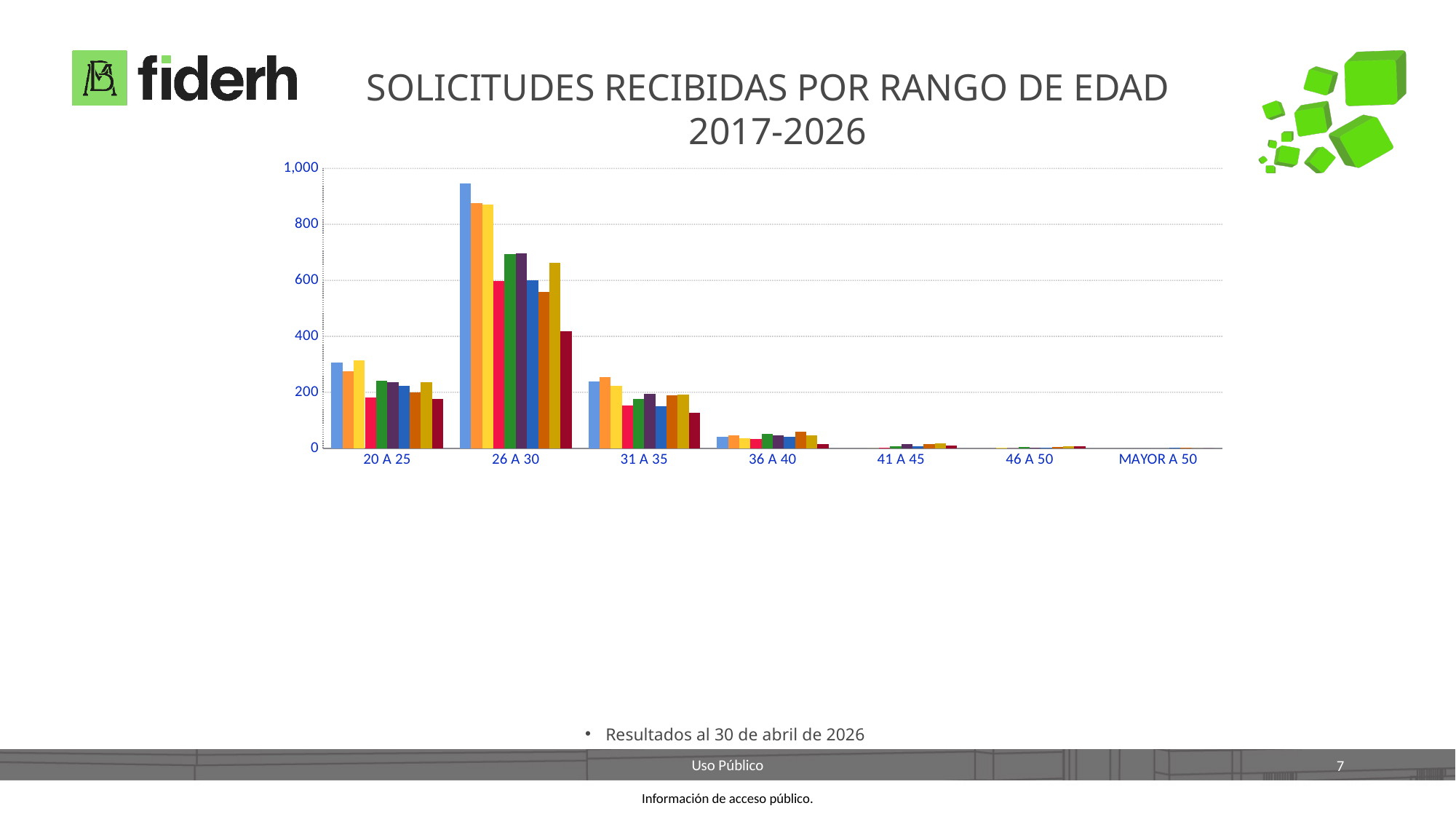
Do the bar heights rise or fall along the x axis from 26 A 30 to MAYOR A 50? fall Are all bars in the 36 A 40 group greater or less than 200? less What is the title of the chart on the slide? SOLICITUDES RECIBIDAS POR RANGO DE EDAD 2017-2026 How many age-range categories are shown on the x axis? 7 What is the highest value shown on the y axis? 1,000 Is the tallest bar in the 26 A 30 group greater or less than 800? greater Which age range has the lowest bars in the chart? MAYOR A 50 Which group has taller bars overall, 26 A 30 or 31 A 35? 26 A 30 Which age range has the highest bars in the chart? 26 A 30 Is the tallest bar in the 31 A 35 group greater or less than 400? less What kind of chart is shown on the slide? bar chart